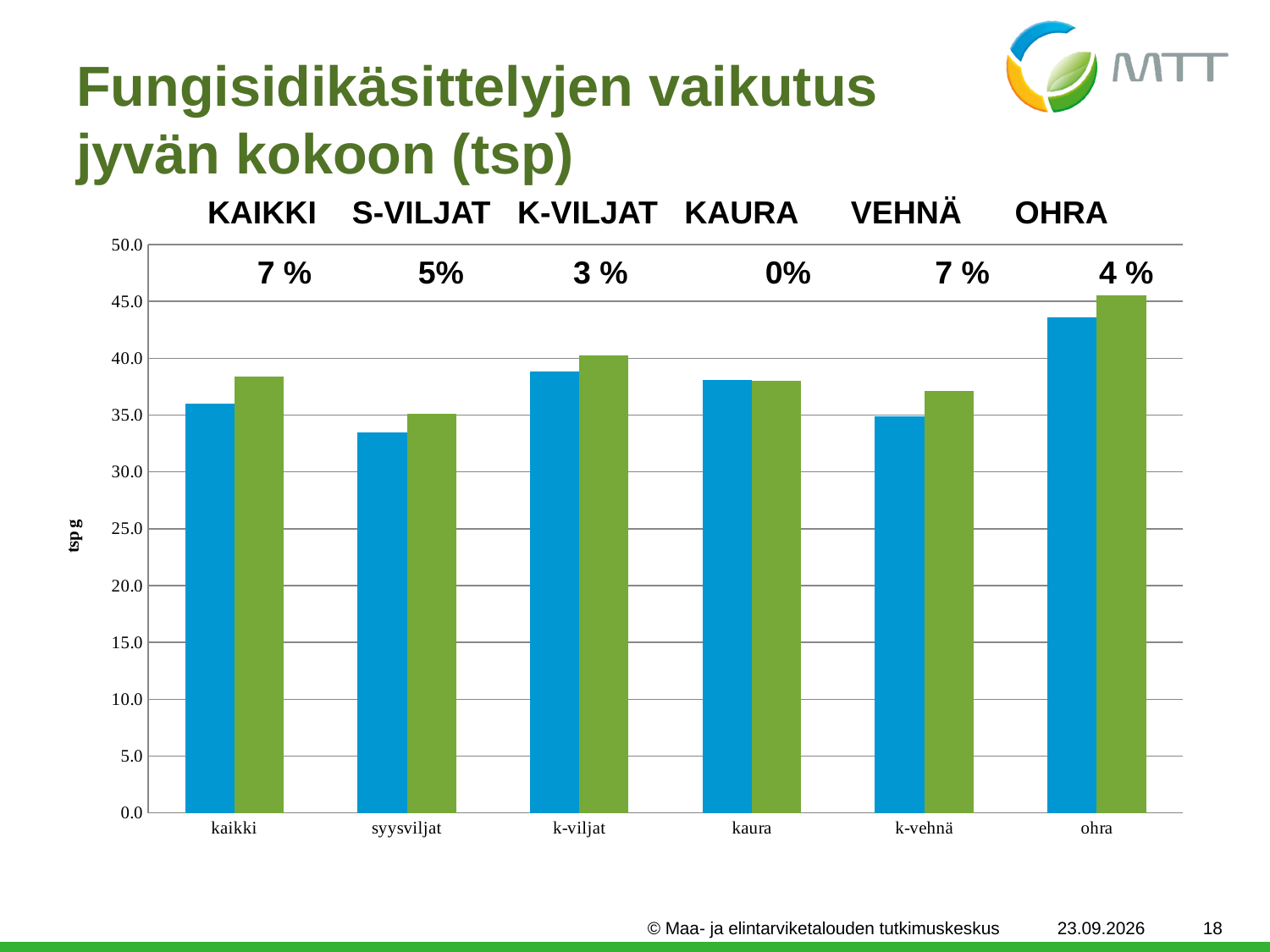
Is the blue bar for ohra greater or less than 40.0? greater Which category has the shortest bar in the chart? syysviljat What is the label on the vertical axis of the chart? tsp g Which category has the tallest bar in the chart? ohra Is the green bar for kaikki greater or less than 40.0? less Which is larger, the blue bar for ohra or the blue bar for kaikki? ohra What percentage is printed above the KAURA group in the chart? 0% Is the blue bar for kaura greater or less than 40.0? less How many categories are shown on the x axis of the chart? 6 Which is larger, the green bar for k-viljat or the green bar for syysviljat? k-viljat What kind of chart is shown on the slide? bar chart